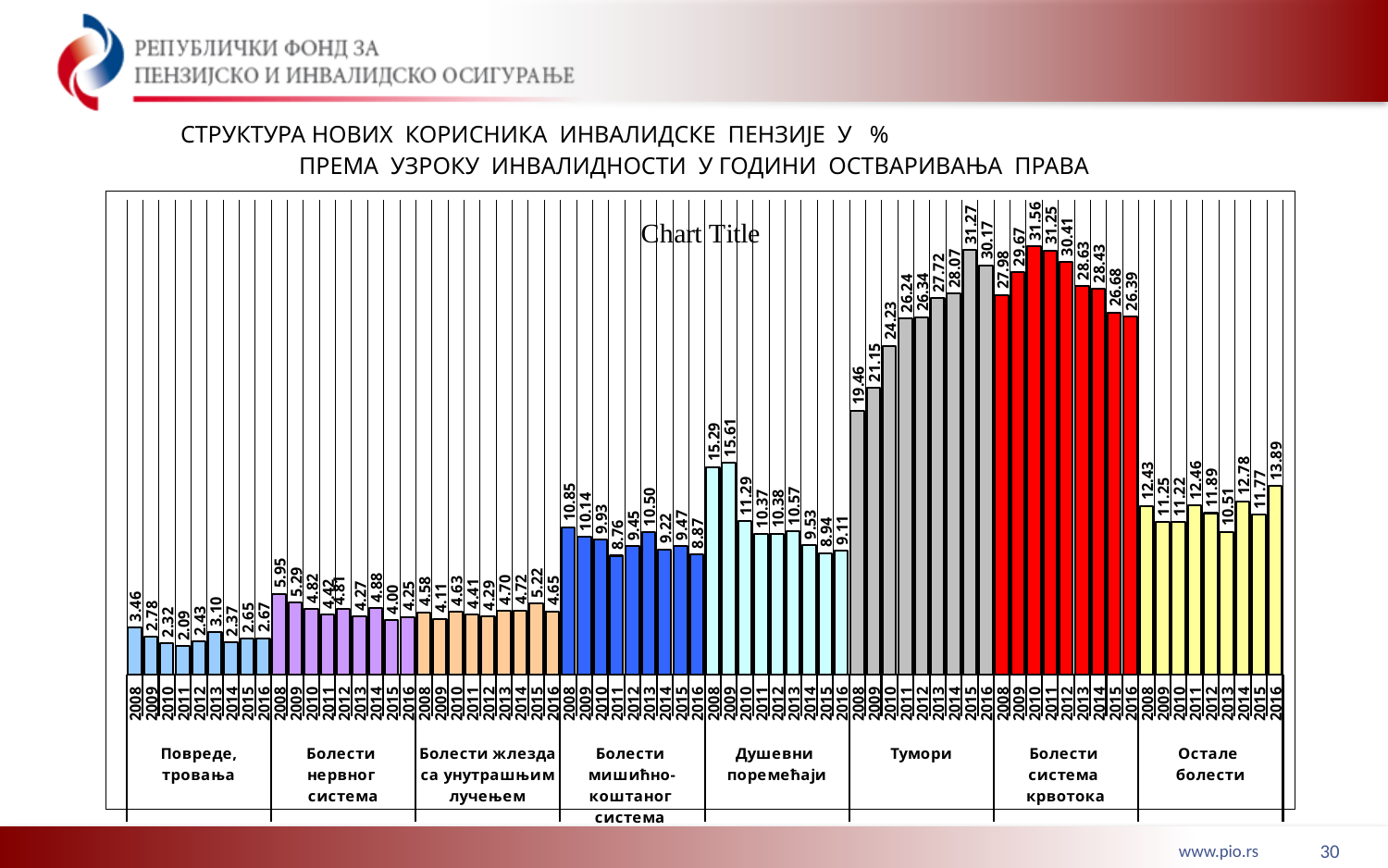
What is the value for Болести система крвотока in 2010? 31.56 What colour are the bars for the Болести система крвотока group? red What kind of chart is shown on the slide? bar chart What is the value for Тумори in 2015? 31.27 How many cause-of-disability groups are shown on the chart? 8 Which year has the highest value in the Тумори group? 2015 What is the value for Остале болести in 2016? 13.89 What is the difference between the Тумори values for 2016 and 2008? 10.71 Which year has the lowest value in the Повреде, тровања group? 2011 What is the value for Душевни поремећаји in 2009? 15.61 Which is larger: the 2016 value for Тумори or the 2016 value for Болести система крвотока? Тумори Do the values for Тумори generally rise or fall from 2008 to 2015? rise